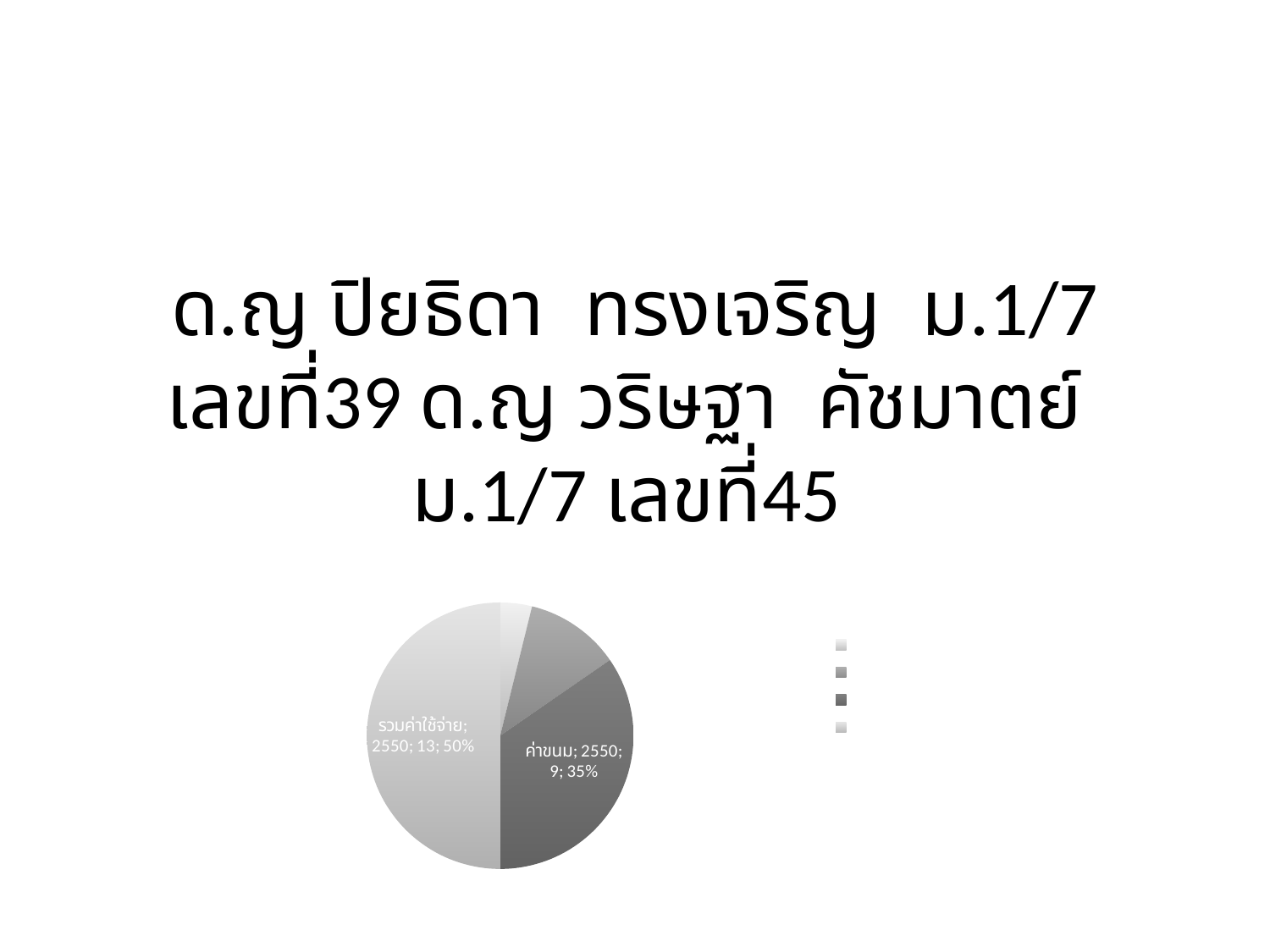
Which labeled slice is larger, รวมค่าใช้จ่าย or ค่าขนม? รวมค่าใช้จ่าย What value is shown for the รวมค่าใช้จ่าย slice of the pie chart? 13 What value is shown for the ค่าขนม slice of the pie chart? 9 What share of the pie does the ค่าขนม slice represent? 35% What is the difference between the values of the รวมค่าใช้จ่าย slice and the ค่าขนม slice? 4 How many slices does the pie chart have? 4 Which slice of the pie chart is the largest? รวมค่าใช้จ่าย What kind of chart is shown on the slide? pie chart What year appears in the data labels of the pie chart? 2550 How many entries does the legend of the pie chart show? 4 What share of the pie does the รวมค่าใช้จ่าย slice represent? 50%